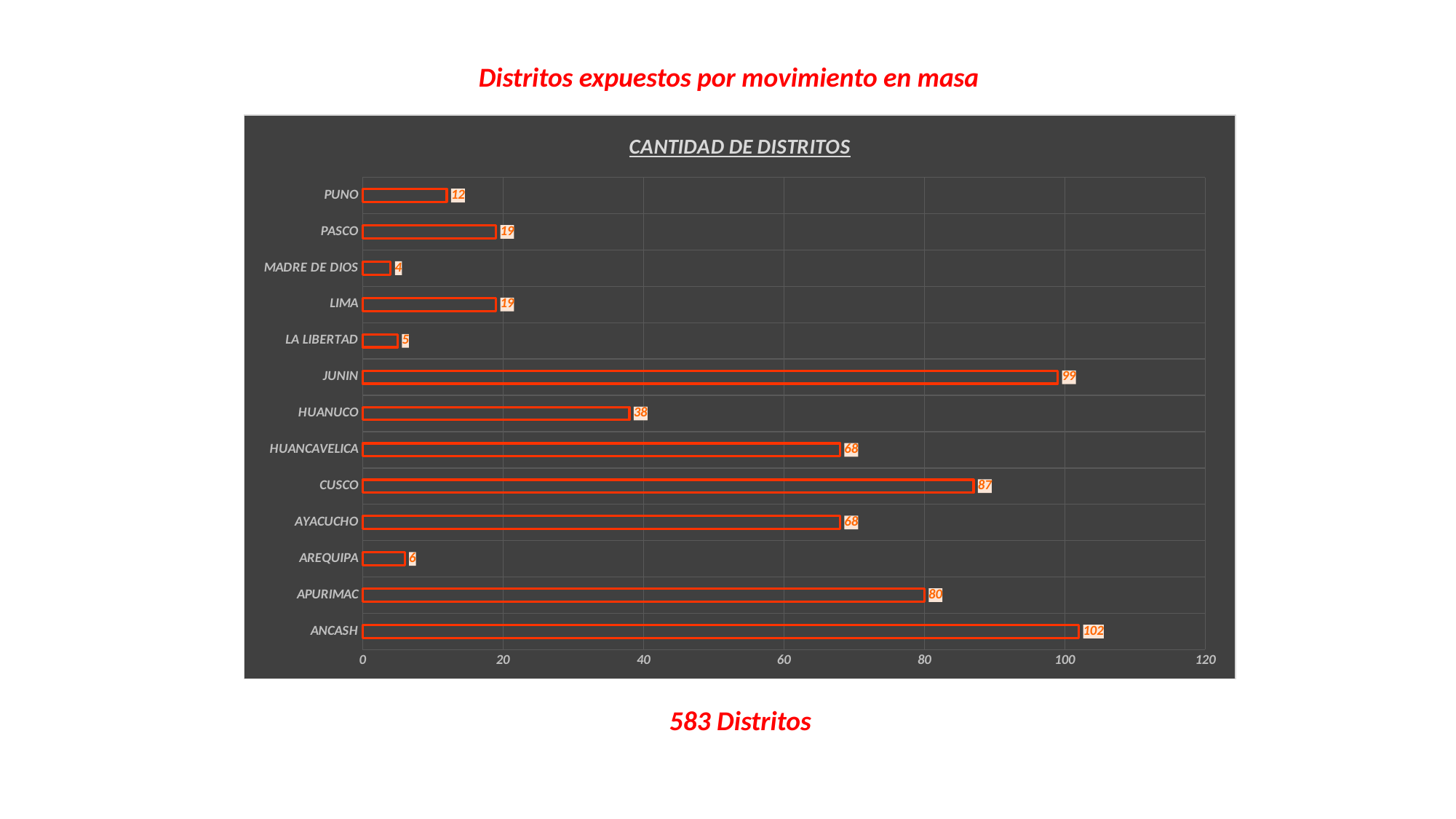
Which category has the highest value? ANCASH What is the value for JUNIN? 99 How many categories are shown in the chart? 13 What kind of chart is shown? bar chart What is the value for MADRE DE DIOS? 4 Which is larger, the value for HUANCAVELICA or the value for HUANUCO? HUANCAVELICA What is the difference between the values for CUSCO and APURIMAC? 7 Is the value for CUSCO greater or less than 80? greater Which category has the lowest value? MADRE DE DIOS What is the difference between the values for ANCASH and JUNIN? 3 What is the value for HUANUCO? 38 What is the title of the chart? CANTIDAD DE DISTRITOS